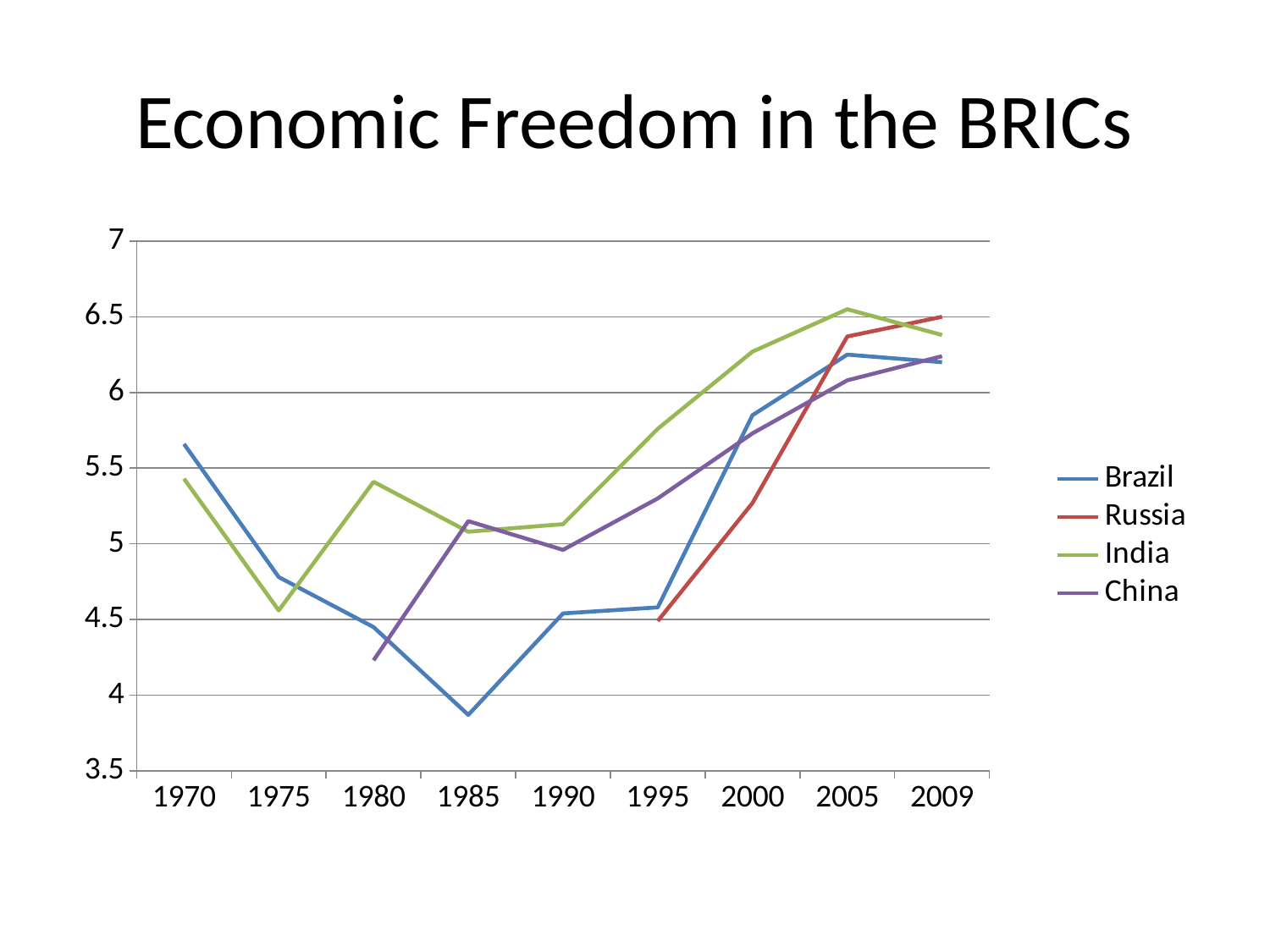
Is the value for Brazil in 1985 greater or less than 4? less Does the value for Russia rise or fall from 1995 to 2009? rise Which series in the legend is drawn in red? Russia Is the value for China in 1980 greater or less than 4.5? less Is the value for Russia in 2009 greater or less than 6? greater Which country has the highest value in 2005? India What kind of chart is shown on the slide? line chart In 1970, which is higher, Brazil or India? Brazil How many years are marked along the x axis? 9 In which year does Brazil reach its lowest value? 1985 How many series does the legend list? 4